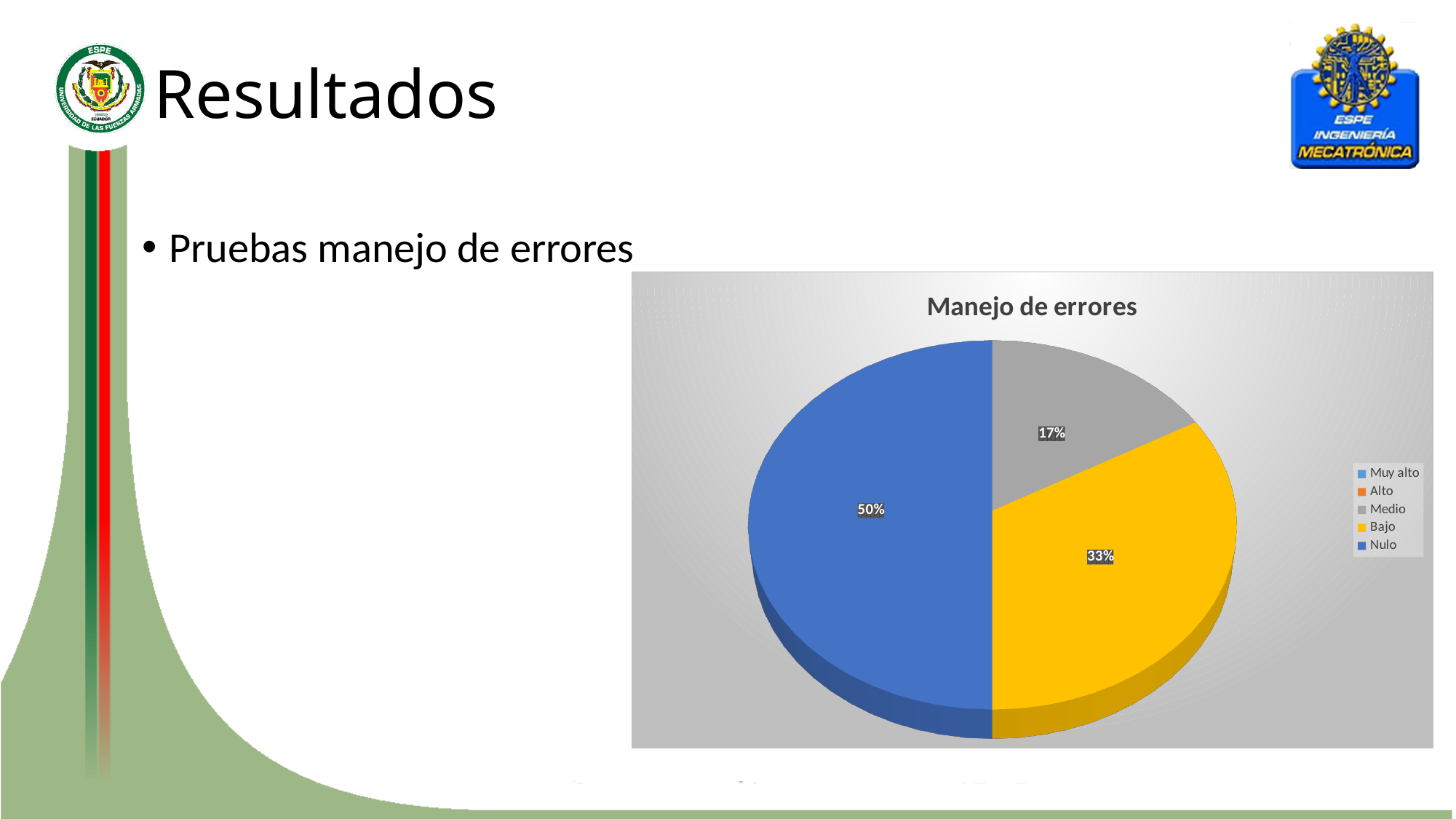
Which category has the largest slice of the pie? Nulo Which slice is larger, Bajo or Medio? Bajo What share of the pie does the Bajo slice represent? 33% What share of the pie does the Nulo slice represent? 50% What share of the pie does the Medio slice represent? 17% What is the difference in percentage points between the Nulo slice and the Bajo slice? 17 Which of the visible slices is the smallest? Medio What kind of chart is shown on the slide? pie chart What colour is the Bajo slice in the pie? yellow What is the title of the chart? Manejo de errores How many entries does the chart's legend list? 5 How many slices with a visible share are shown in the pie? 3